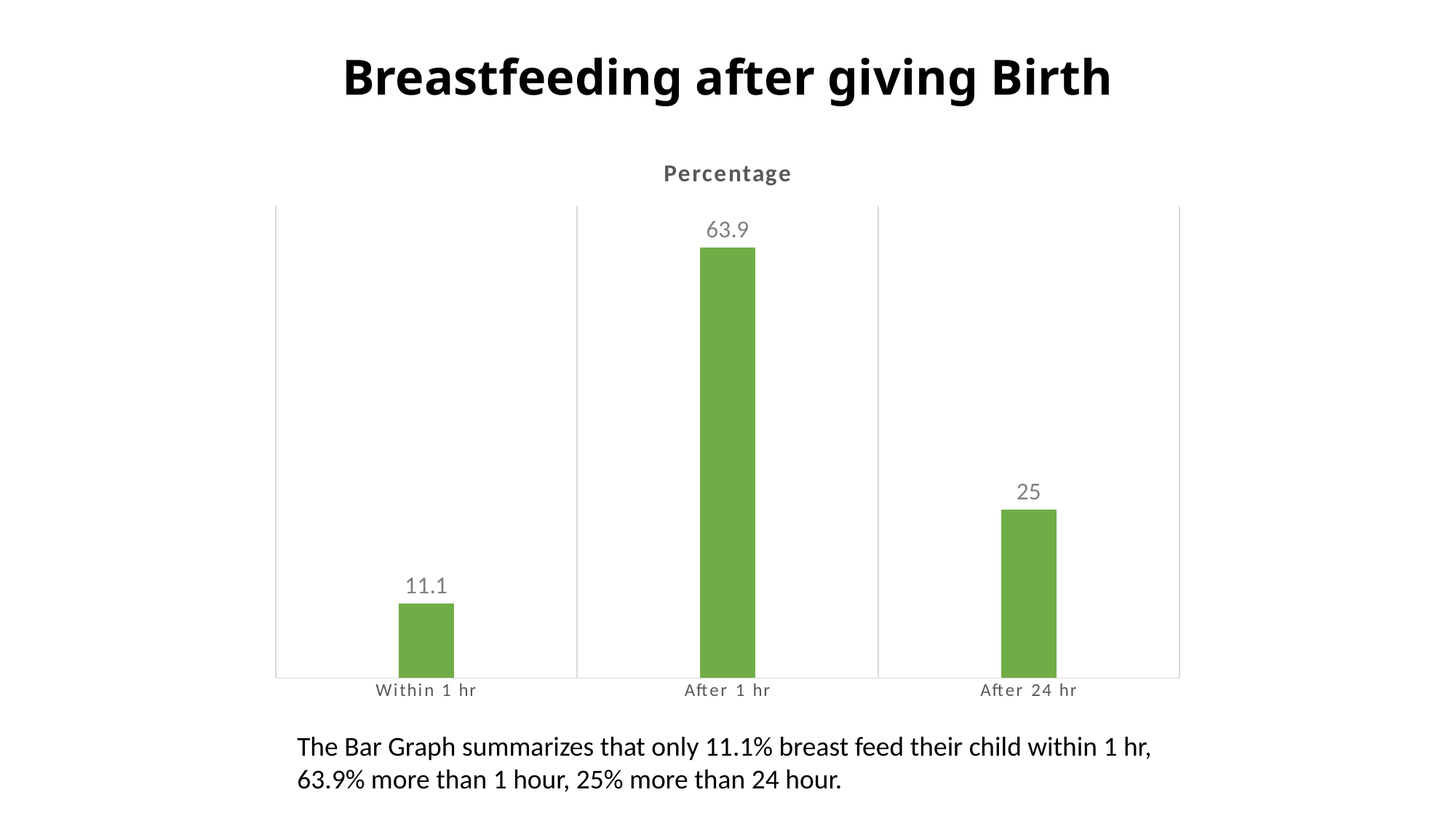
What colour are the bars in the chart? Green What is the value for After 24 hr? 25 What is the value for Within 1 hr? 11.1 What is the difference between the values for After 24 hr and Within 1 hr? 13.9 How many categories are shown on the x axis? 3 Which category has the highest value? After 1 hr What is the title of the chart? Percentage What is the value for After 1 hr? 63.9 Which is larger, the value for After 24 hr or the value for Within 1 hr? After 24 hr Which category has the lowest value? Within 1 hr What kind of chart is shown on the slide? Bar chart What is the difference between the values for After 1 hr and After 24 hr? 38.9